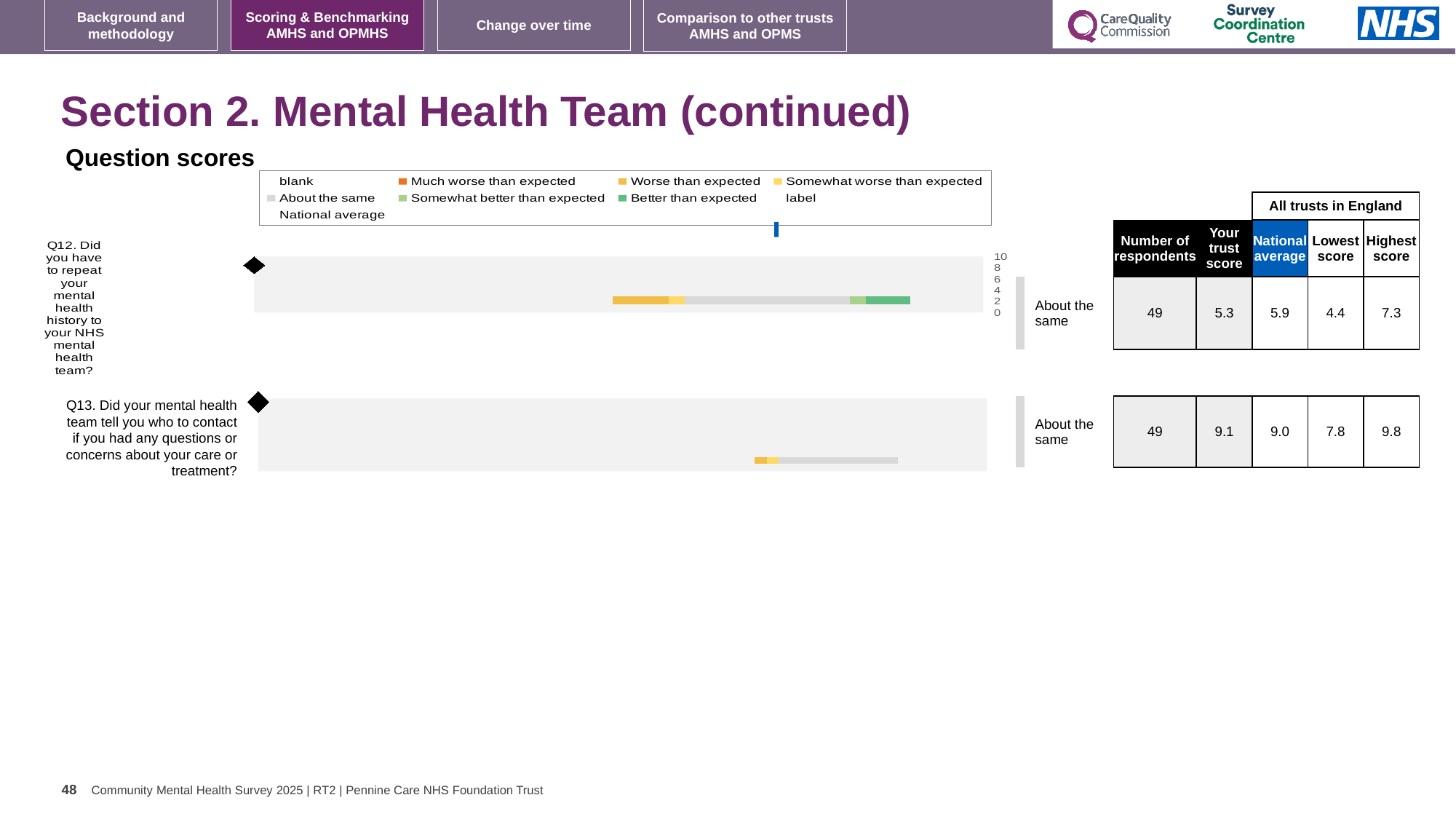
What is the difference between the highest and lowest scores for Q13? 2.0 What is the trust score for Q13 (Did your mental health team tell you who to contact if you had any questions or concerns about your care or treatment?)? 9.1 What is the national average score for Q13? 9.0 What benchmark category is shown for Q12? About the same How many questions are shown on the slide? 2 What is the difference between the national average and the trust score for Q12? 0.6 What is the trust score for Q12 (Did you have to repeat your mental health history to your NHS mental health team?)? 5.3 How many respondents answered Q13? 49 What is the lowest score among all trusts in England for Q12? 4.4 What is the highest score among all trusts in England for Q12? 7.3 What is the national average score for Q12? 5.9 For Q13, which is larger: the trust score or the national average? Trust score